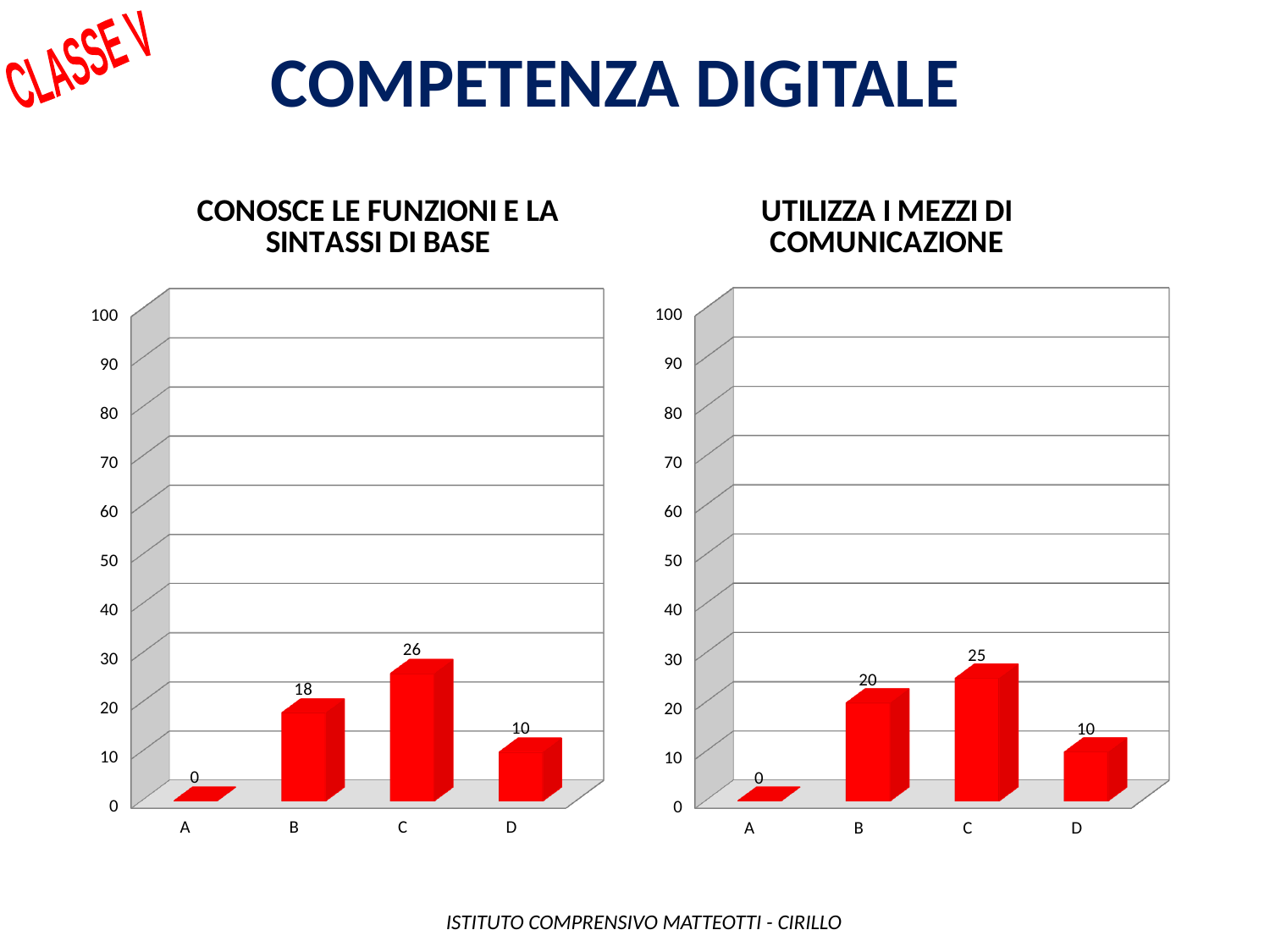
In the 'CONOSCE LE FUNZIONI E LA SINTASSI DI BASE' chart, which is larger, the value for B or the value for D? B What is the title of the chart on the right side of the slide? UTILIZZA I MEZZI DI COMUNICAZIONE How many categories are shown in the 'CONOSCE LE FUNZIONI E LA SINTASSI DI BASE' chart? 4 In the 'UTILIZZA I MEZZI DI COMUNICAZIONE' chart, what is the value for category B? 20 In the 'CONOSCE LE FUNZIONI E LA SINTASSI DI BASE' chart, what is the difference between the values for C and B? 8 In the 'UTILIZZA I MEZZI DI COMUNICAZIONE' chart, which category has the lowest value? A In the 'CONOSCE LE FUNZIONI E LA SINTASSI DI BASE' chart, which category has the highest value? C In the 'CONOSCE LE FUNZIONI E LA SINTASSI DI BASE' chart, what is the value for category A? 0 In the 'CONOSCE LE FUNZIONI E LA SINTASSI DI BASE' chart, what is the value for category C? 26 In the 'UTILIZZA I MEZZI DI COMUNICAZIONE' chart, is the value for C greater or less than 30? less What kind of chart is the 'UTILIZZA I MEZZI DI COMUNICAZIONE' chart? Bar chart In the 'UTILIZZA I MEZZI DI COMUNICAZIONE' chart, what is the difference between the values for C and D? 15